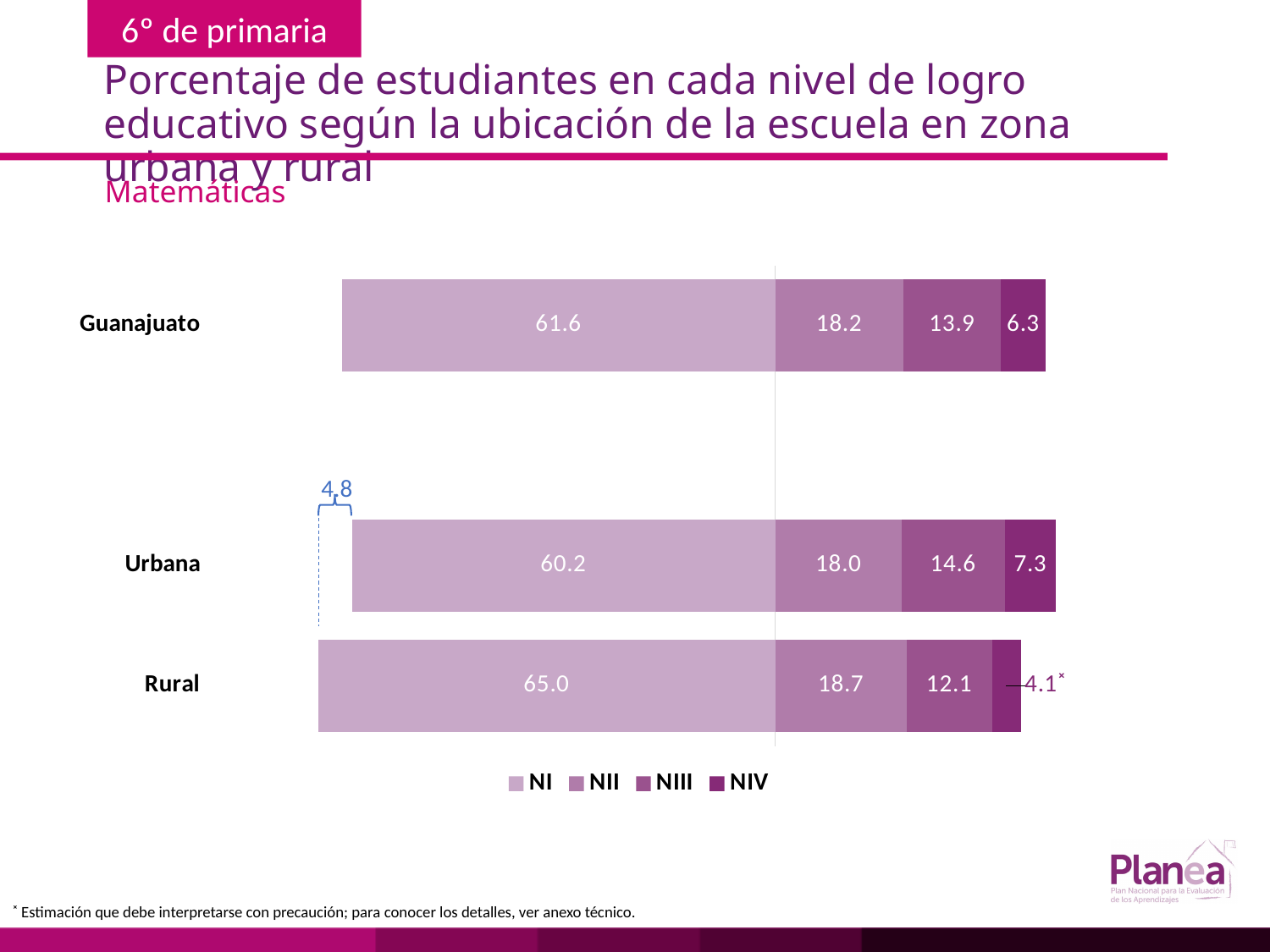
What is the NII value for Rural? 18.7 Which is larger, the NIII value for Urbana or the NIII value for Rural? Urbana What is the difference between the NI values for Rural and Urbana? 4.8 What is the NI value for Rural? 65.0 What is the total of the stacked bar for Guanajuato? 100.0 What is the NIII value for Guanajuato? 13.9 How many series does the legend list? 4 What kind of chart is shown on the slide? Stacked bar chart What is the NIV value for Urbana? 7.3 How many categories are shown in the chart? 3 Which category has the lowest NIV value? Rural Which category has the highest NI value? Rural